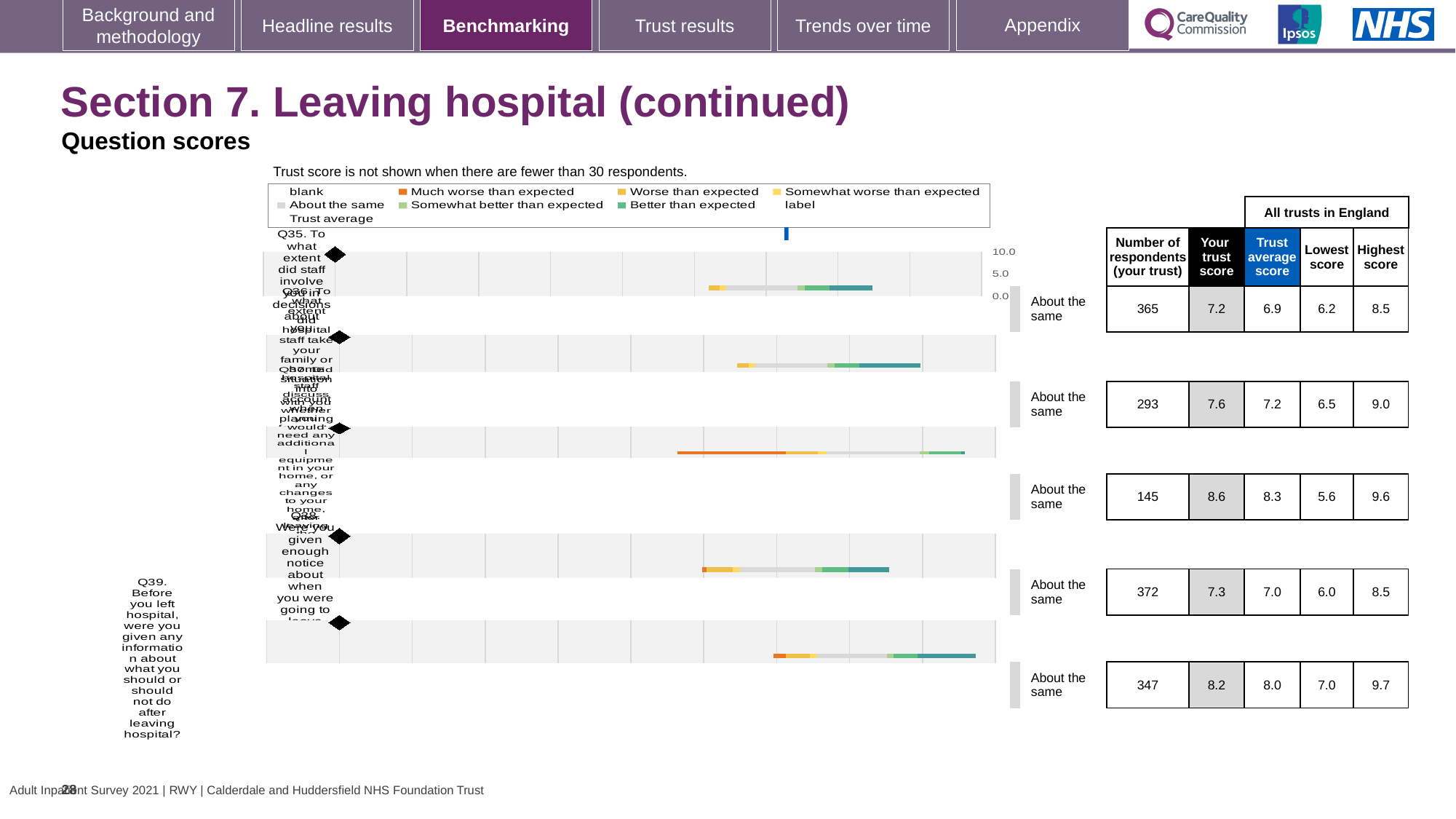
What is the difference between this trust's score and the trust average score for Q36? 0.4 How many respondents answered Q35 at this trust? 365 Is this trust's score for Q38 higher or lower than the trust average score for Q38? higher What is the trust score for Q39 (Before you left hospital, were you given any information about what you should or should not do after leaving hospital?)? 8.2 What is the lowest score across all trusts in England for Q38? 6.0 What is the highest score across all trusts in England for Q37? 9.6 What benchmark category is shown for Q35 on this slide? About the same How many questions are shown on this slide's chart? 5 What is the trust average score for Q39? 8.0 Which question has the fewest respondents at this trust? Q37 Which question has the highest trust score for this trust? Q37 What is the title of the section shown on this slide? Section 7. Leaving hospital (continued)